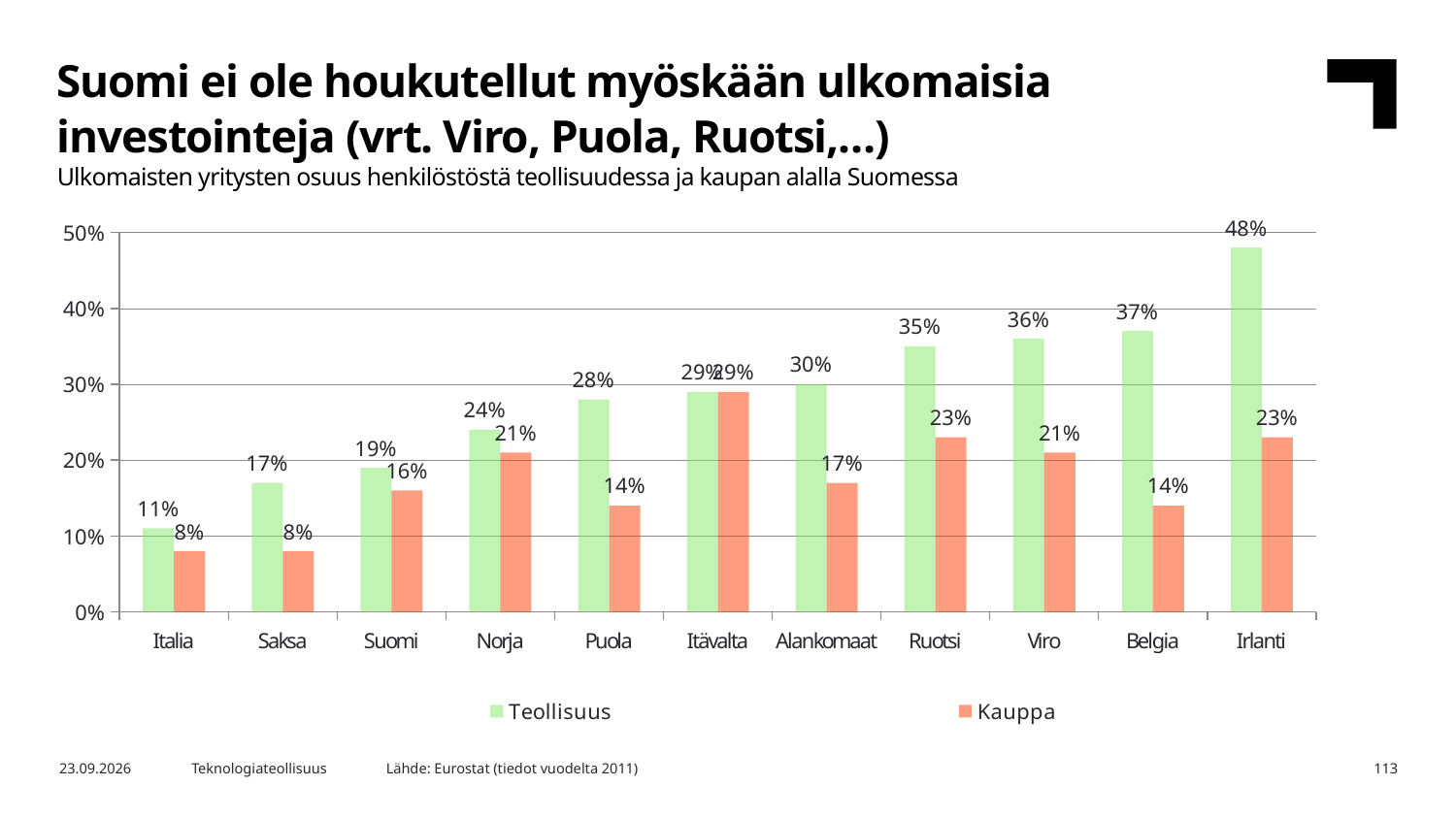
Which country has the highest Kauppa value? Itävalta What is the Kauppa value for Viro? 21% What is the Teollisuus value for Irlanti? 48% Which is larger, the Kauppa value for Ruotsi or the Kauppa value for Puola? Ruotsi How many countries are shown on the x axis? 11 How many series does the legend list? 2 Which country has the lowest Teollisuus value? Italia What is the difference between the Teollisuus values for Belgia and Suomi? 18 percentage points Which country has the highest Teollisuus value? Irlanti What is the Teollisuus value for Suomi? 19% What kind of chart is shown on the slide? Bar chart Do the Teollisuus values rise or fall from Italia to Irlanti along the x axis? Rise